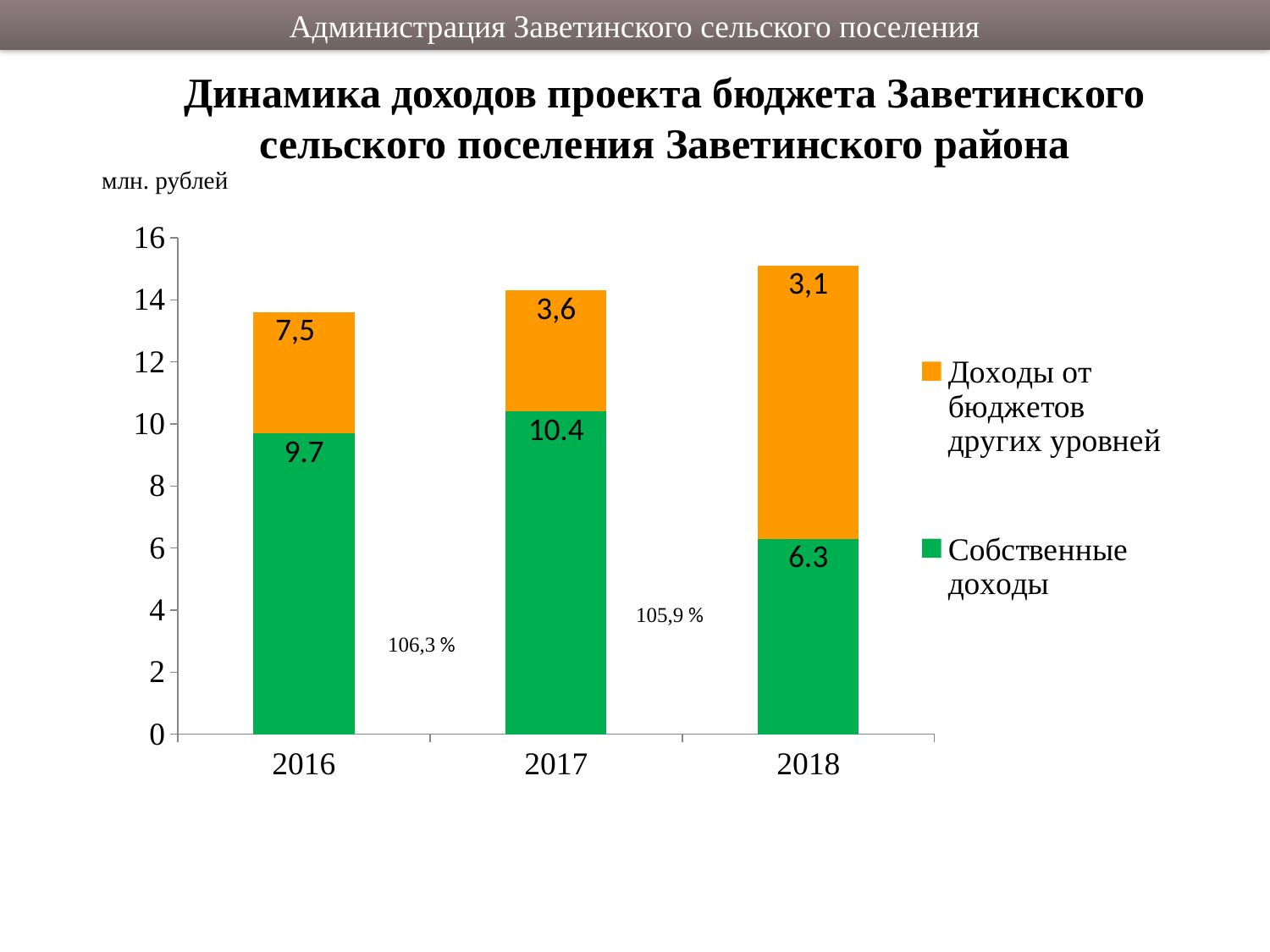
What is the value of Собственные доходы for 2017? 10.4 What is the value of Доходы от бюджетов других уровней for 2018? 3,1 In which year is Собственные доходы lowest? 2018 What is the value of Доходы от бюджетов других уровней for 2017? 3,6 How many years are shown on the x axis of the chart? 3 What is the difference between Собственные доходы in 2017 and 2016? 0.7 What type of chart is shown on the slide? stacked bar chart What is the value of Собственные доходы for 2018? 6.3 Is the total height of the 2018 bar greater or less than 14? greater What is the value of Собственные доходы for 2016? 9.7 How many series does the legend list? 2 In which year is Собственные доходы highest? 2017